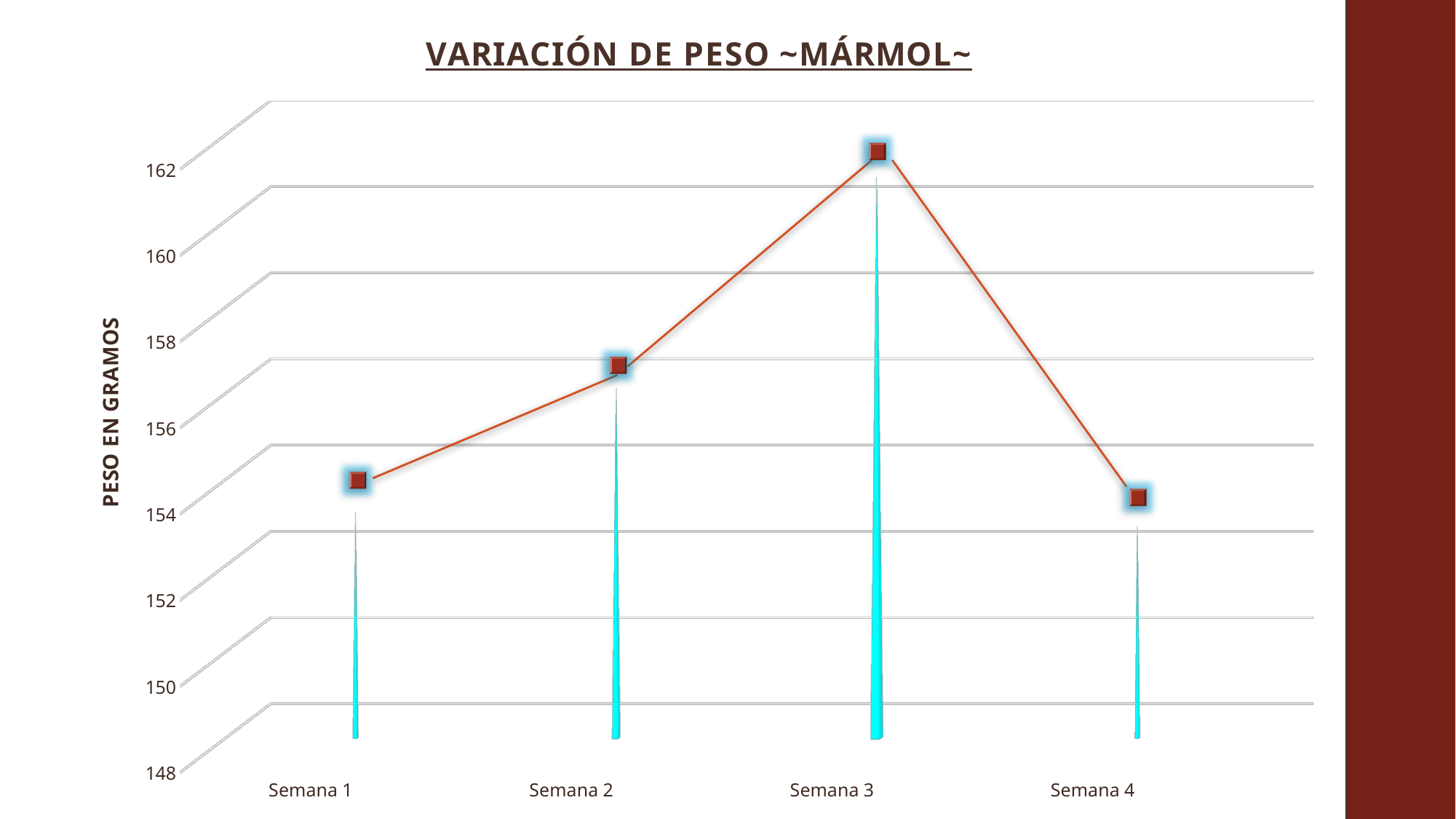
Is the value for Semana 2 greater or less than 154? greater Which is larger, the value for Semana 2 or the value for Semana 1? Semana 2 What is the title of the chart? VARIACIÓN DE PESO ~MÁRMOL~ How many weeks (categories) are plotted on the x axis? 4 What kind of chart is shown on the slide? bar chart Is the value for Semana 4 greater or less than 152? greater Which is larger, the value for Semana 3 or the value for Semana 4? Semana 3 What is the label on the vertical axis of the chart? PESO EN GRAMOS How does the weight change from Semana 1 to Semana 4? It rises through Semana 3, then falls at Semana 4 Is the value for Semana 3 greater or less than 160? greater Which week has the highest weight? Semana 3